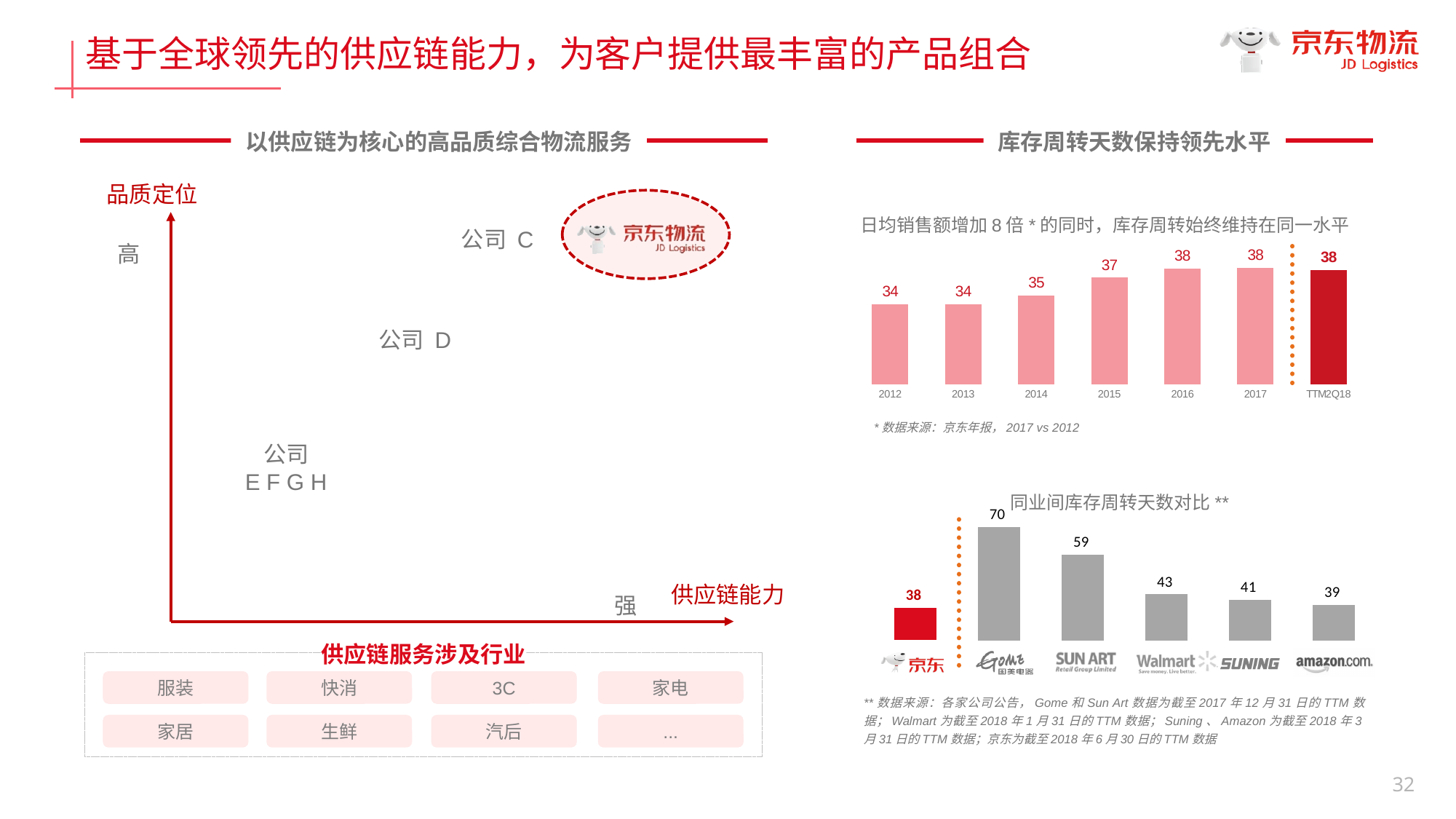
In the top-right chart (库存周转天数保持领先水平), what is the value for TTM2Q18? 38 In the bottom-right chart (同业间库存周转天数对比), which company has the highest value? Gome In the bottom-right chart (同业间库存周转天数对比), what is the difference between Gome and 京东? 32 In the bottom-right chart (同业间库存周转天数对比), how many companies are compared? 6 What kind of chart is the top-right chart (库存周转天数保持领先水平)? bar chart In the bottom-right chart (同业间库存周转天数对比), which company has the lowest value? 京东 In the top-right chart (库存周转天数保持领先水平), do the values rise or fall from 2012 to 2017? rise In the top-right chart (库存周转天数保持领先水平), how many bars are plotted? 7 In the bottom-right chart (同业间库存周转天数对比), what is the value for Sun Art? 59 In the bottom-right chart (同业间库存周转天数对比), which is larger, the value for Walmart or the value for Suning? Walmart In the top-right chart (库存周转天数保持领先水平), what is the value for 2012? 34 In the top-right chart (库存周转天数保持领先水平), what is the difference between the 2017 value and the 2012 value? 4